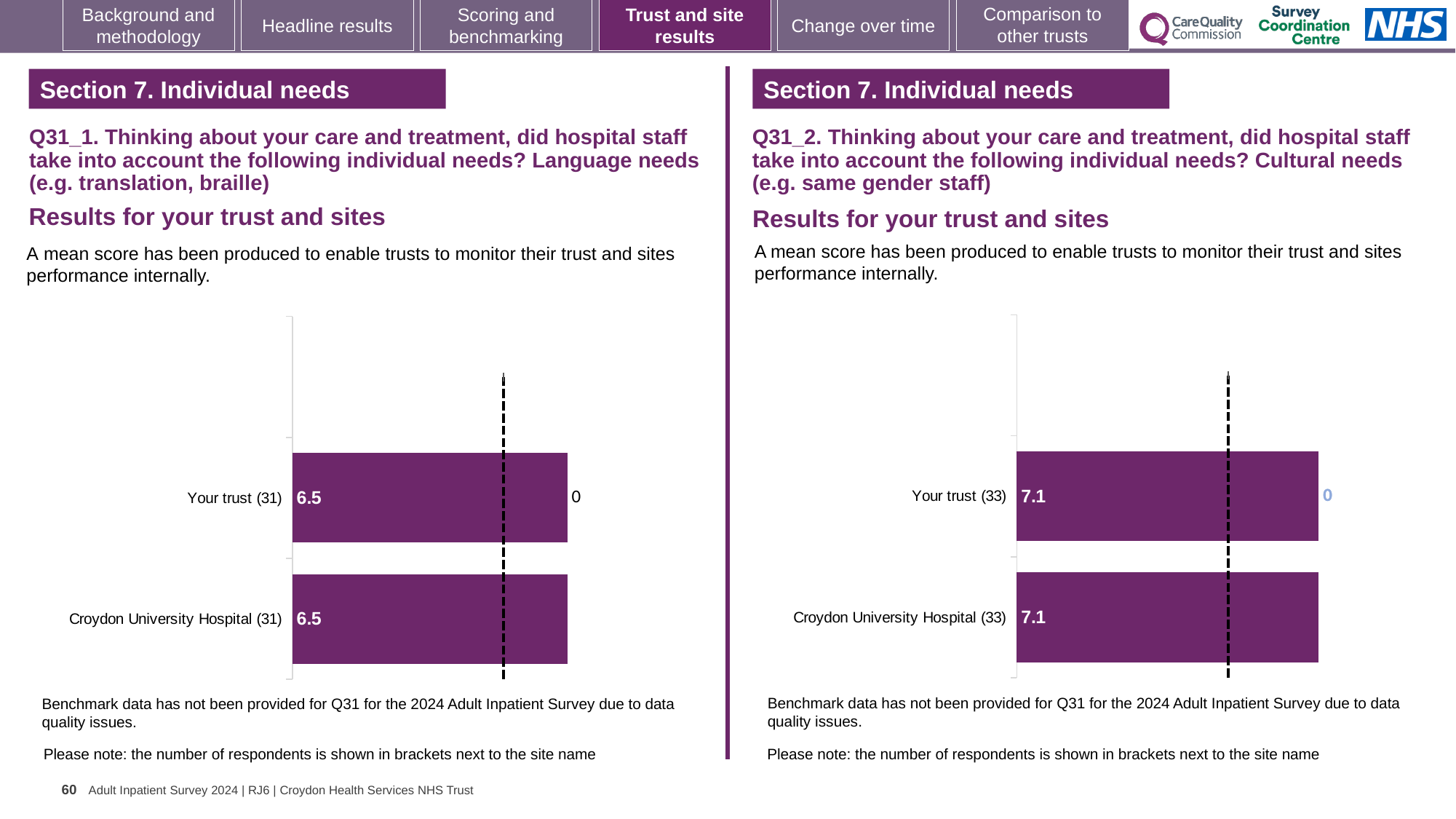
On the left chart (Q31_1, Language needs), how many bars are plotted? 2 On the right chart (Q31_2, Cultural needs), what is the mean score for Your trust? 7.1 What is the difference between the Your trust score on the right chart (Q31_2) and the Your trust score on the left chart (Q31_1)? 0.6 On the left chart (Q31_1, Language needs), what is the difference between the Your trust score and the Croydon University Hospital score? 0 Which is larger: the Your trust score on the left chart (Q31_1) or the Your trust score on the right chart (Q31_2)? Right chart (Q31_2), 7.1 On the left chart (Q31_1, Language needs), how many respondents are shown in brackets next to Your trust? 31 On the left chart (Q31_1, Language needs), what is the mean score for Your trust? 6.5 On the left chart (Q31_1, Language needs), what is the mean score for Croydon University Hospital? 6.5 What kind of chart is used on the left (Q31_1, Language needs)? Bar chart On the right chart (Q31_2, Cultural needs), what is the mean score for Croydon University Hospital? 7.1 On the right chart (Q31_2, Cultural needs), how many categories are shown? 2 On the right chart (Q31_2, Cultural needs), how many respondents are shown in brackets next to Croydon University Hospital? 33